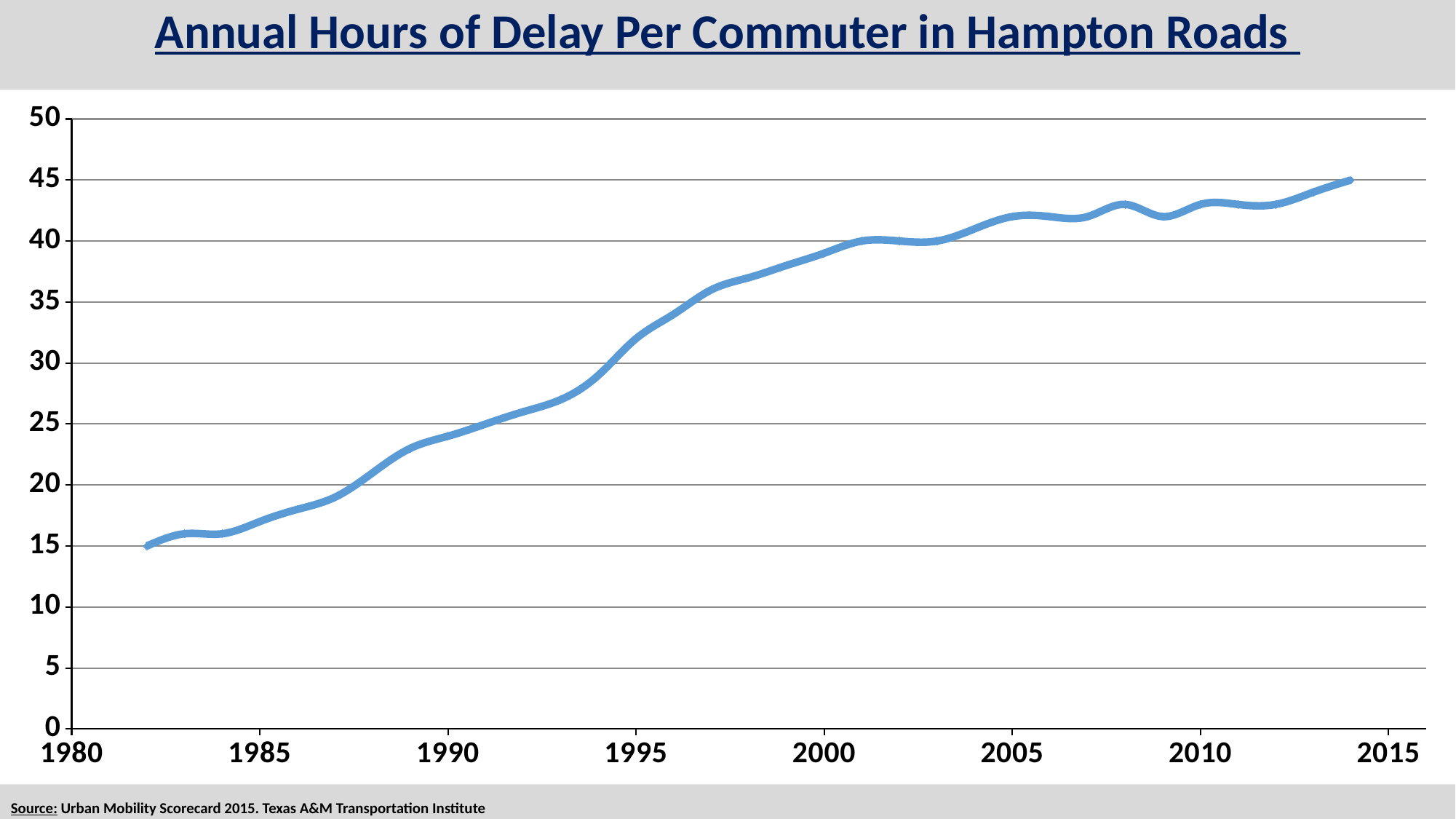
Is the value for 1995 greater or less than 30? greater Which year has the larger annual hours of delay per commuter, 1990 or 2000? 2000 In which year is the annual hours of delay per commuter lowest? 1982 Do the annual hours of delay per commuter generally rise or fall from 1982 to 2014? rise What is the annual hours of delay per commuter at the end of the line, in 2014? 45 Is the value for 2010 greater or less than 40? greater In which year is the annual hours of delay per commuter highest? 2014 Is the value for 1985 greater or less than 20? less What is the source cited for the chart? Urban Mobility Scorecard 2015. Texas A&M Transportation Institute What kind of chart is shown on the slide? line chart What is the annual hours of delay per commuter at the start of the line, in 1982? 15 What is the title of the chart? Annual Hours of Delay Per Commuter in Hampton Roads